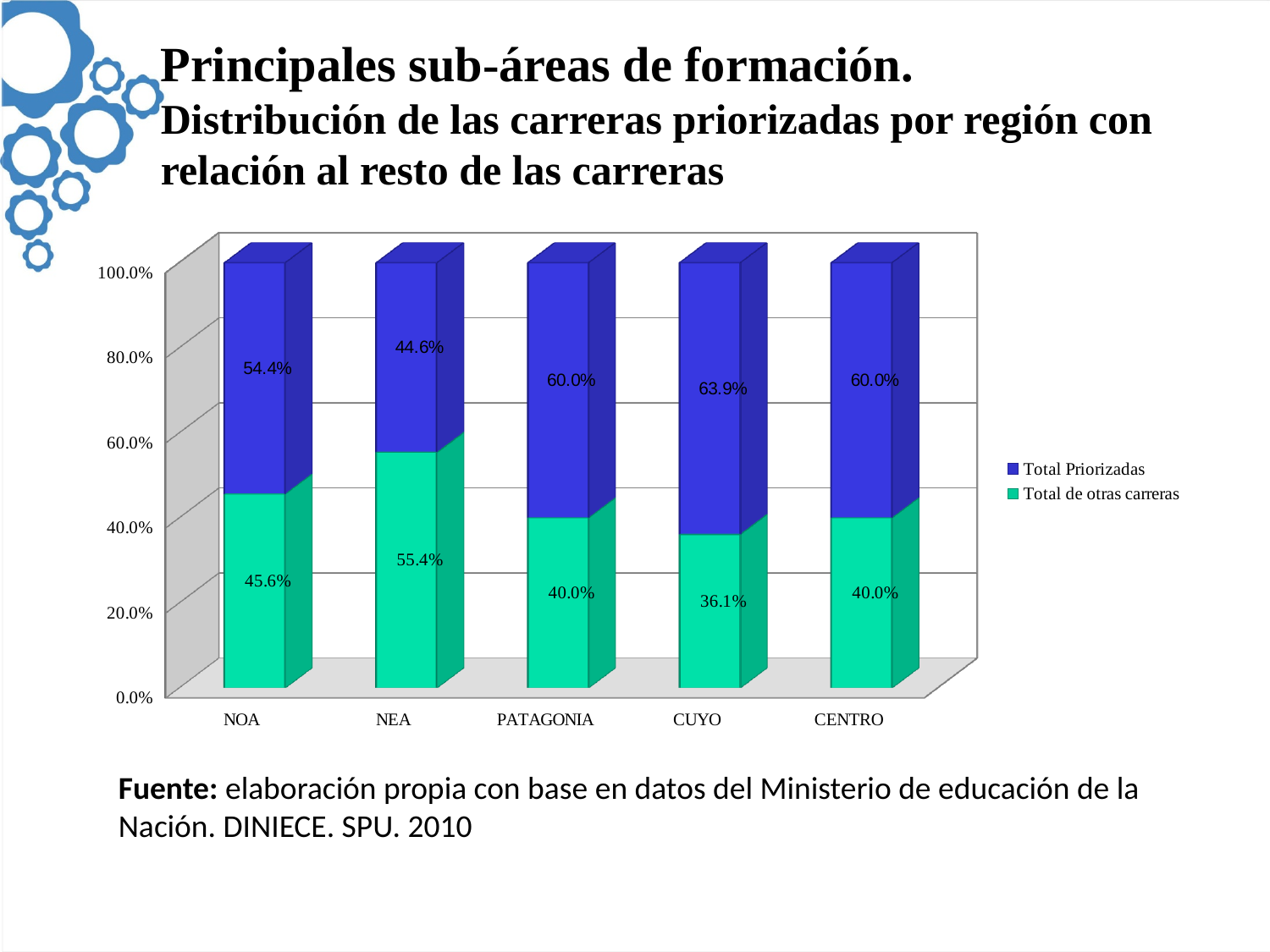
What is the value of Total de otras carreras for NEA? 55.4% How many regions are shown on the x axis? 5 Which region has the lowest value for Total Priorizadas? NEA What is the value of Total Priorizadas for CUYO? 63.9% Which region has the highest value for Total de otras carreras? NEA What is the value of Total de otras carreras for CENTRO? 40.0% Which region has the highest value for Total Priorizadas? CUYO Which is larger for NEA: Total Priorizadas or Total de otras carreras? Total de otras carreras What is the difference between Total Priorizadas and Total de otras carreras for CUYO? 27.8% How many series does the legend list? 2 What kind of chart is shown on the slide? Stacked bar chart What is the value of Total Priorizadas for NOA? 54.4%